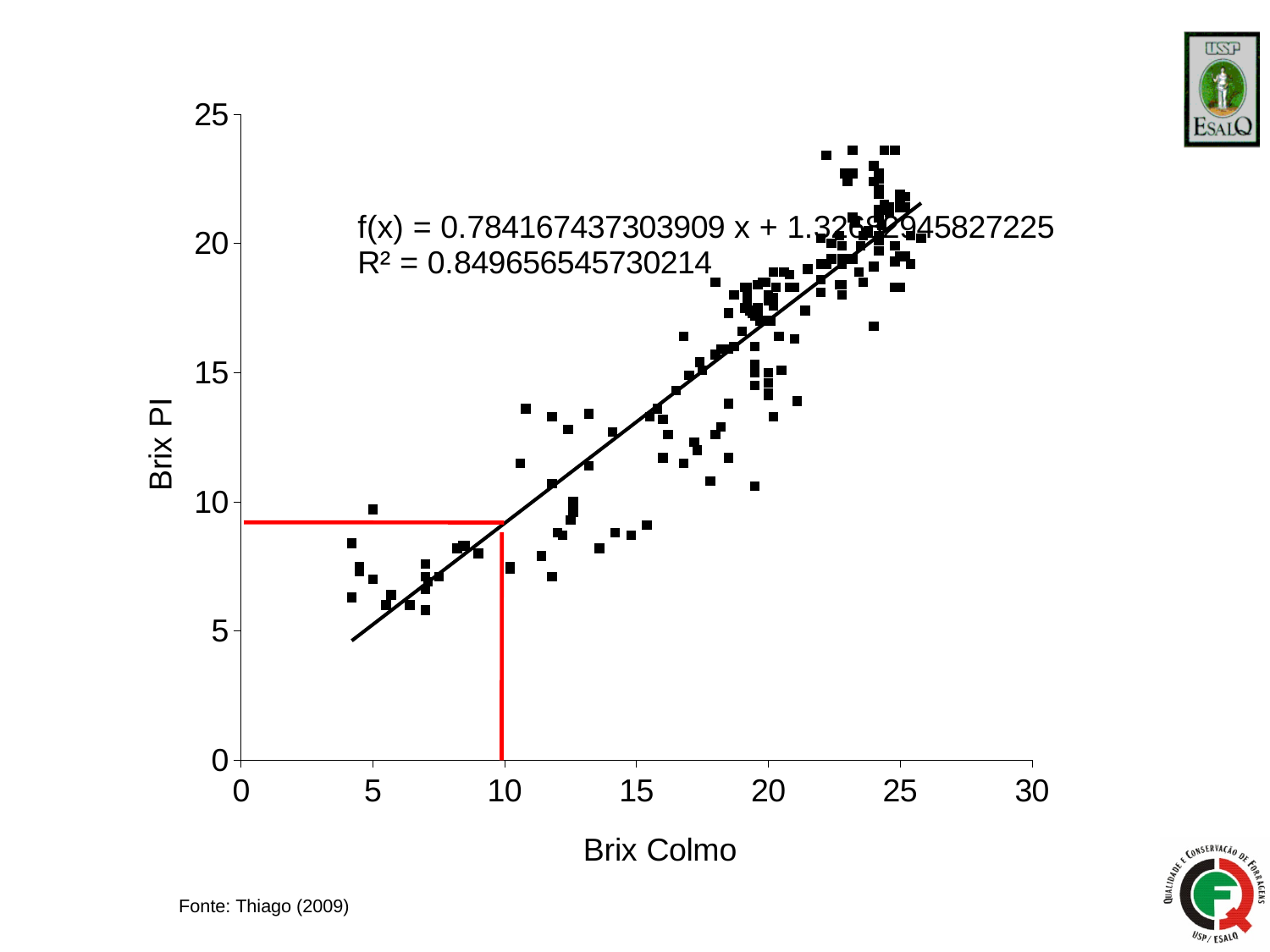
What is the label of the y axis? Brix PI What is the highest tick value shown on the x axis? 30 What is the highest tick value shown on the y axis? 25 What is the label of the x axis? Brix Colmo What kind of chart is shown on the slide? scatter chart What is the slope coefficient of x in the fitted equation f(x) shown on the chart? 0.784167437303909 What R² value is printed on the chart? 0.849656545730214 Is the Brix PI value of the highest plotted point greater or less than 20? greater Is the R² value shown on the chart greater or less than 0.8? greater Do the Brix PI values generally rise or fall as Brix Colmo increases? rise Is the Brix PI level marked by the red horizontal line greater or less than 10? less